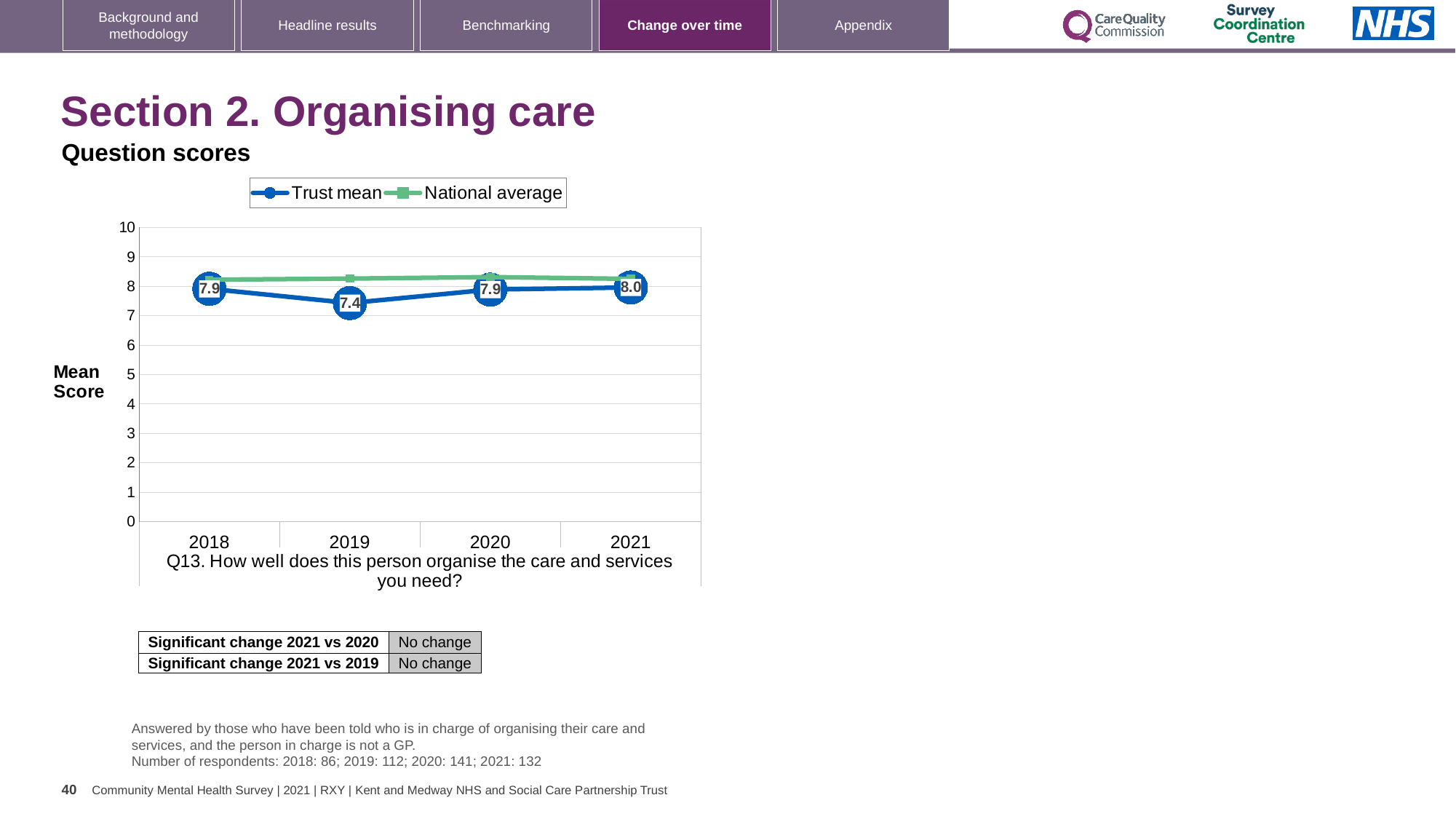
What is the Trust mean score for 2018? 7.9 How many series does the legend list? 2 How many years are plotted on the x axis? 4 What is the Trust mean score for 2019? 7.4 Which year has the larger Trust mean score, 2019 or 2021? 2021 What is the difference between the Trust mean scores for 2021 and 2019? 0.6 Does the Trust mean score rise or fall from 2019 to 2021? Rise Is the National average value for 2019 greater or less than 8? greater What kind of chart is shown on the slide? Line chart In which year is the Trust mean score lowest? 2019 What is the Trust mean score for 2021? 8.0 In which year is the Trust mean score highest? 2021